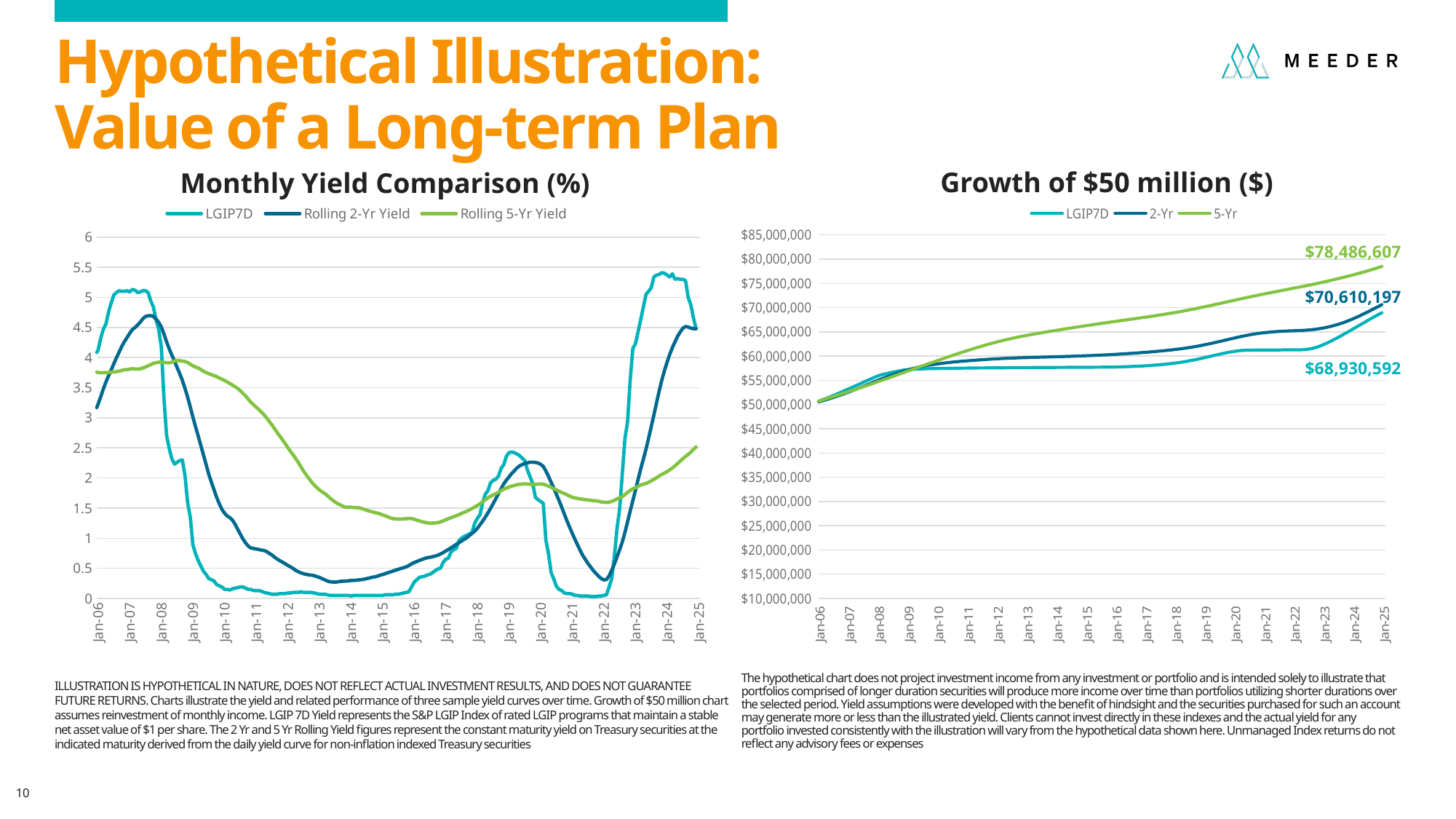
On the Growth of $50 million ($) chart, what is the final value shown for the 2-Yr series? $70,610,197 On the Monthly Yield Comparison (%) chart, is the LGIP7D value at Jan-24 greater or less than 5? greater On the Growth of $50 million ($) chart, which series ends with the lowest value? LGIP7D How many series does the legend of the Monthly Yield Comparison (%) chart list? 3 On the Growth of $50 million ($) chart, does the 5-Yr series generally rise or fall from Jan-06 to Jan-25? rise On the Growth of $50 million ($) chart, what is the final value shown for the LGIP7D series? $68,930,592 On the Growth of $50 million ($) chart, is the LGIP7D value at Jan-20 greater or less than $65,000,000? less On the Growth of $50 million ($) chart, what is the final value shown for the 5-Yr series? $78,486,607 What kind of chart is the Growth of $50 million ($) chart? line chart On the Growth of $50 million ($) chart, which ends higher, the 2-Yr series or the LGIP7D series? 2-Yr On the Growth of $50 million ($) chart, what is the difference between the final 5-Yr value and the final 2-Yr value? $7,876,410 On the Growth of $50 million ($) chart, which series ends with the highest value? 5-Yr